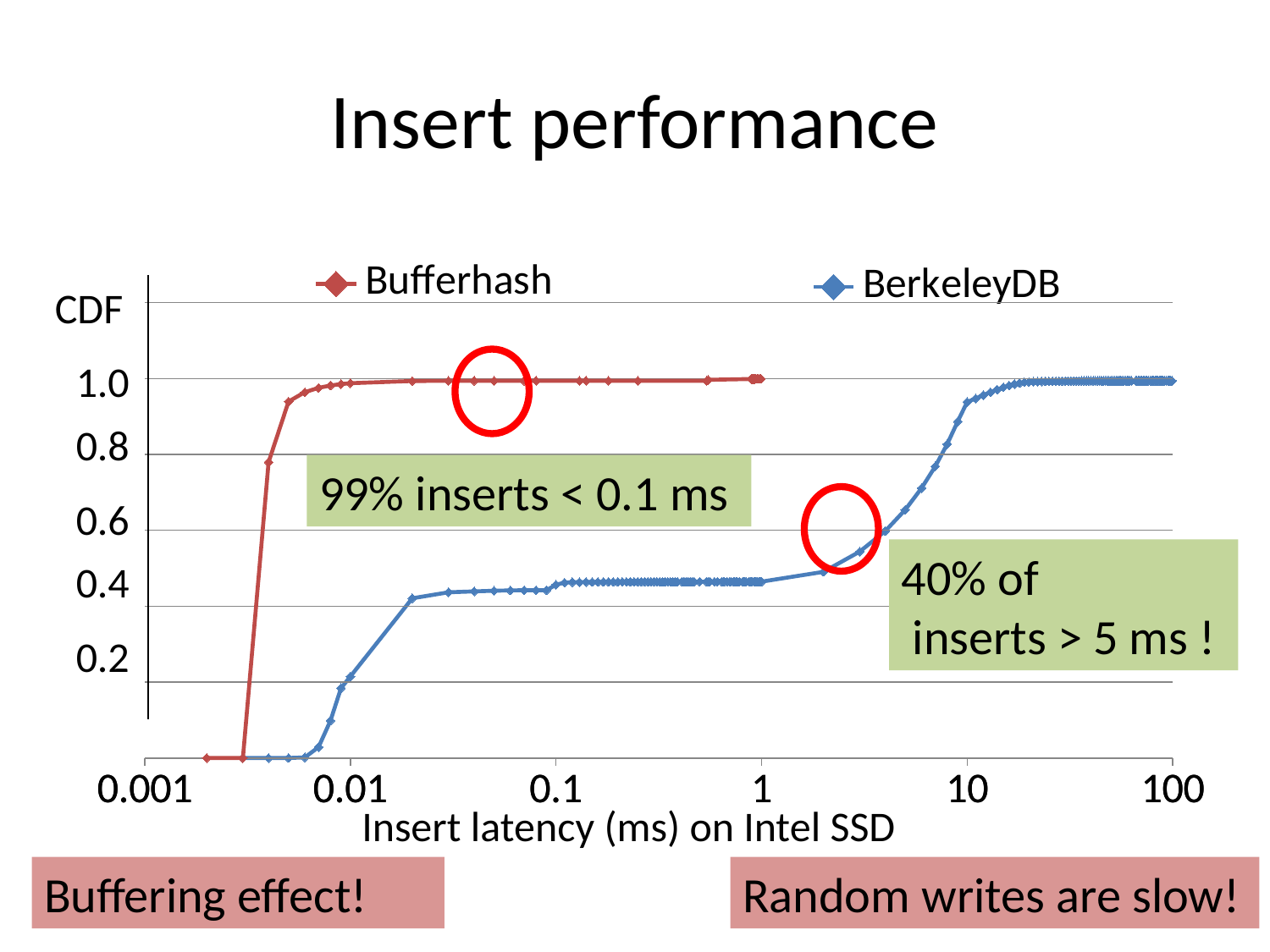
At an insert latency of 0.1 ms, which series has the higher CDF value, Bufferhash or BerkeleyDB? Bufferhash Is the CDF value for BerkeleyDB at 1 ms greater or less than 0.6? less According to the annotation on the chart, what percentage of Bufferhash inserts take less than 0.1 ms? 99% What kind of chart is shown on the slide? Line chart Which series reaches a CDF of 1.0 at a lower insert latency, Bufferhash or BerkeleyDB? Bufferhash Is the CDF value for Bufferhash at 0.01 ms greater or less than 0.8? greater What are the two series named in the legend? Bufferhash and BerkeleyDB How many series does the legend list? 2 Is the CDF value for BerkeleyDB at 10 ms greater or less than 0.8? greater What is the label of the x axis? Insert latency (ms) on Intel SSD Does the BerkeleyDB curve rise or fall as insert latency increases along the x axis? rise